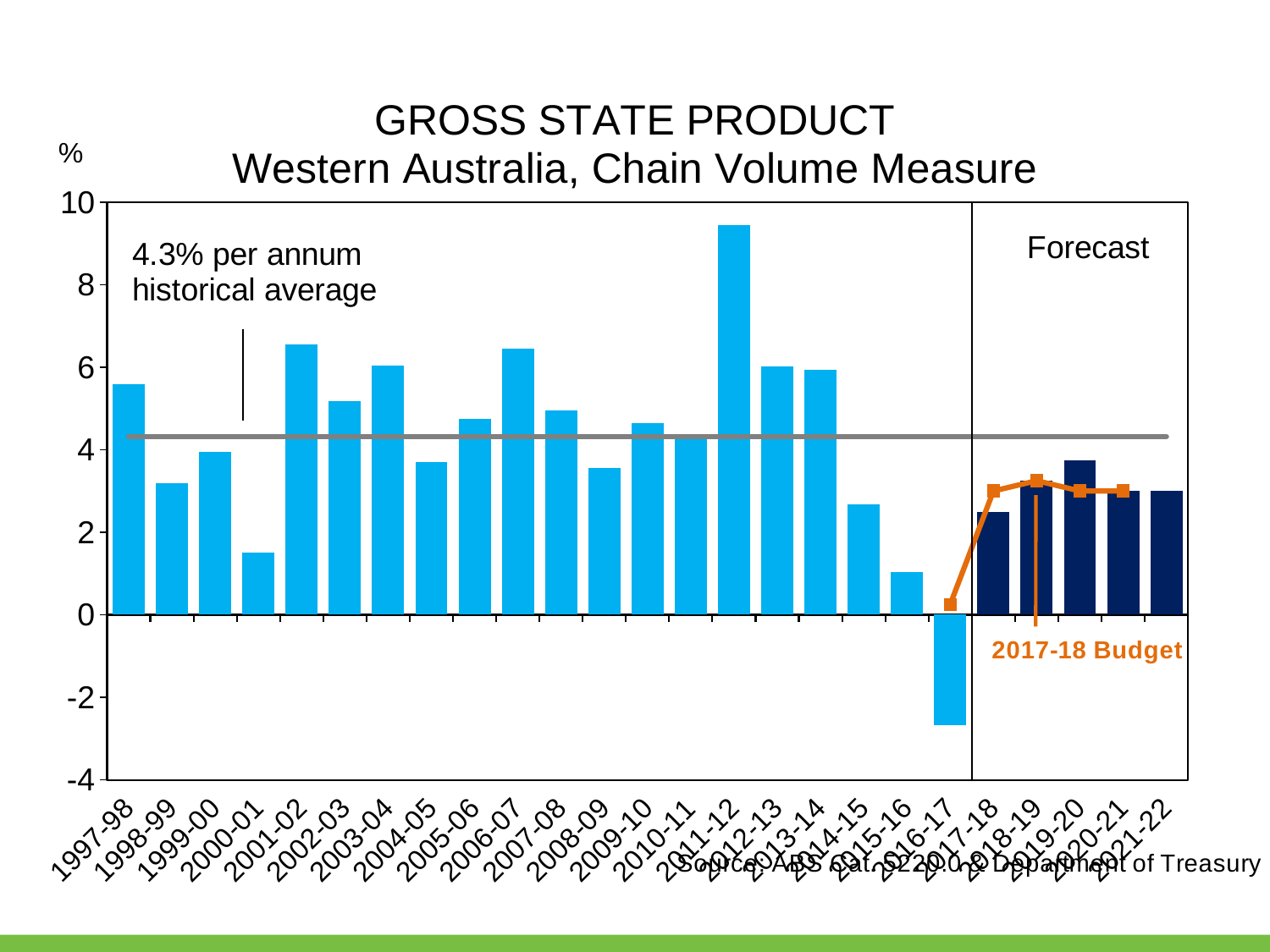
What kind of chart is shown on the slide? bar and line chart How many years are shown along the x axis? 25 Is the value for 2011-12 greater or less than 8? greater Which year has the lowest gross state product growth? 2016-17 Which is larger, the value for 2015-16 or the value for 2016-17? 2015-16 Which year has the highest gross state product growth? 2011-12 What is the historical average annual growth rate shown on the chart? 4.3% Is the value for 2000-01 greater or less than 2? less Which is larger, the value for 2011-12 or the value for 2012-13? 2011-12 Is the value for 2001-02 greater or less than 6? greater What is the title of the chart? GROSS STATE PRODUCT Western Australia, Chain Volume Measure